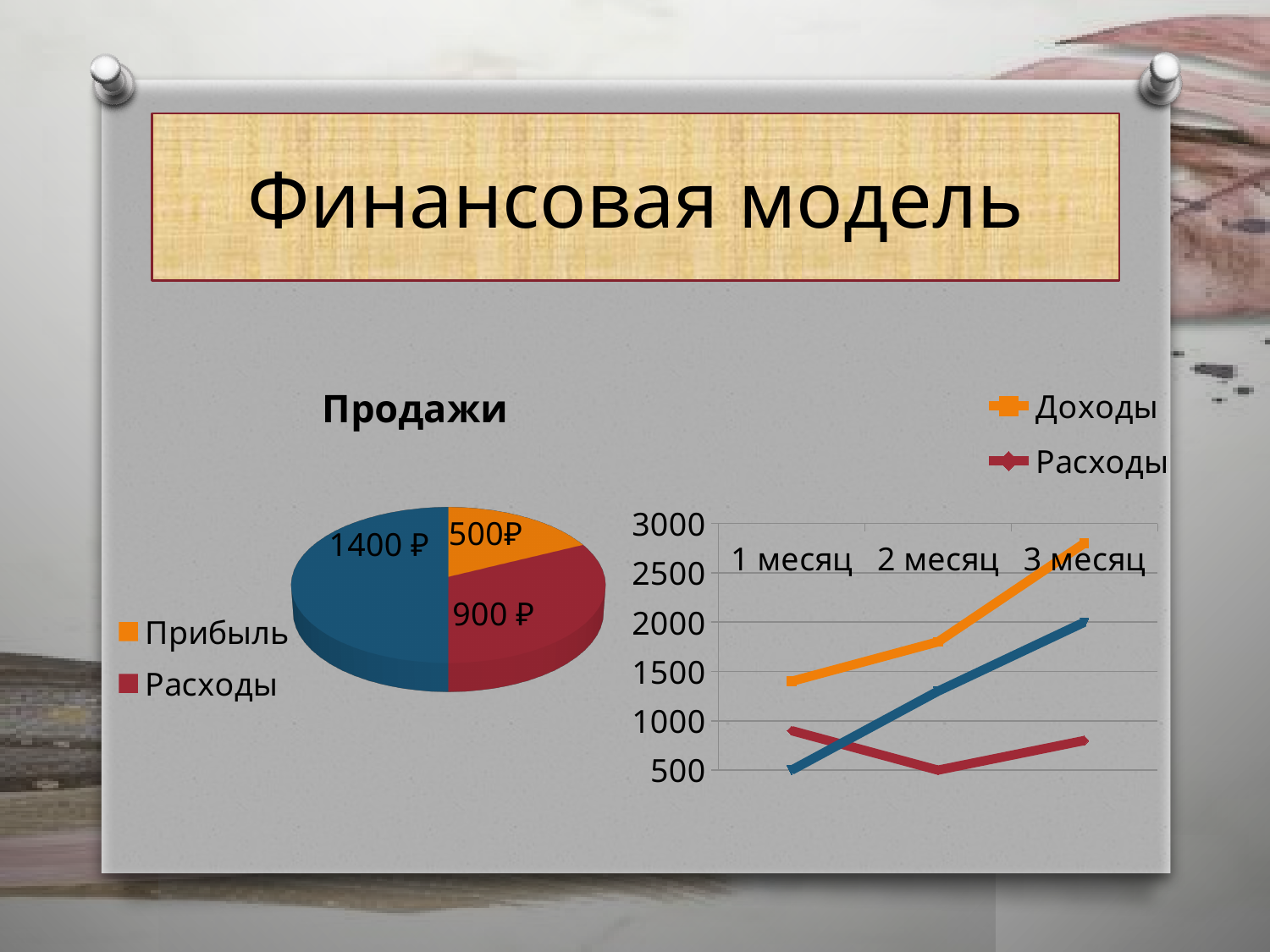
On the pie chart titled "Продажи", what colour is the Прибыль slice? Orange On the pie chart titled "Продажи", what is the difference between Расходы and Прибыль? 400 ₽ On the line chart on the right, is the value for Расходы in 2 месяц greater or less than 1000? less On the pie chart titled "Продажи", what is the value for Прибыль? 500₽ On the line chart on the right, do the values for Доходы rise or fall from 1 месяц to 3 месяц? rise On the pie chart titled "Продажи", what is the value of the largest slice? 1400 ₽ On the pie chart titled "Продажи", which is larger, Прибыль or Расходы? Расходы On the pie chart titled "Продажи", what is the value for Расходы? 900 ₽ On the line chart on the right, is the value for Доходы in 3 месяц greater or less than 2500? greater On the line chart on the right, how many series does the legend list? 2 On the line chart on the right, how many months are shown on the x axis? 3 What kind of chart is the chart on the right side of the slide? Line chart